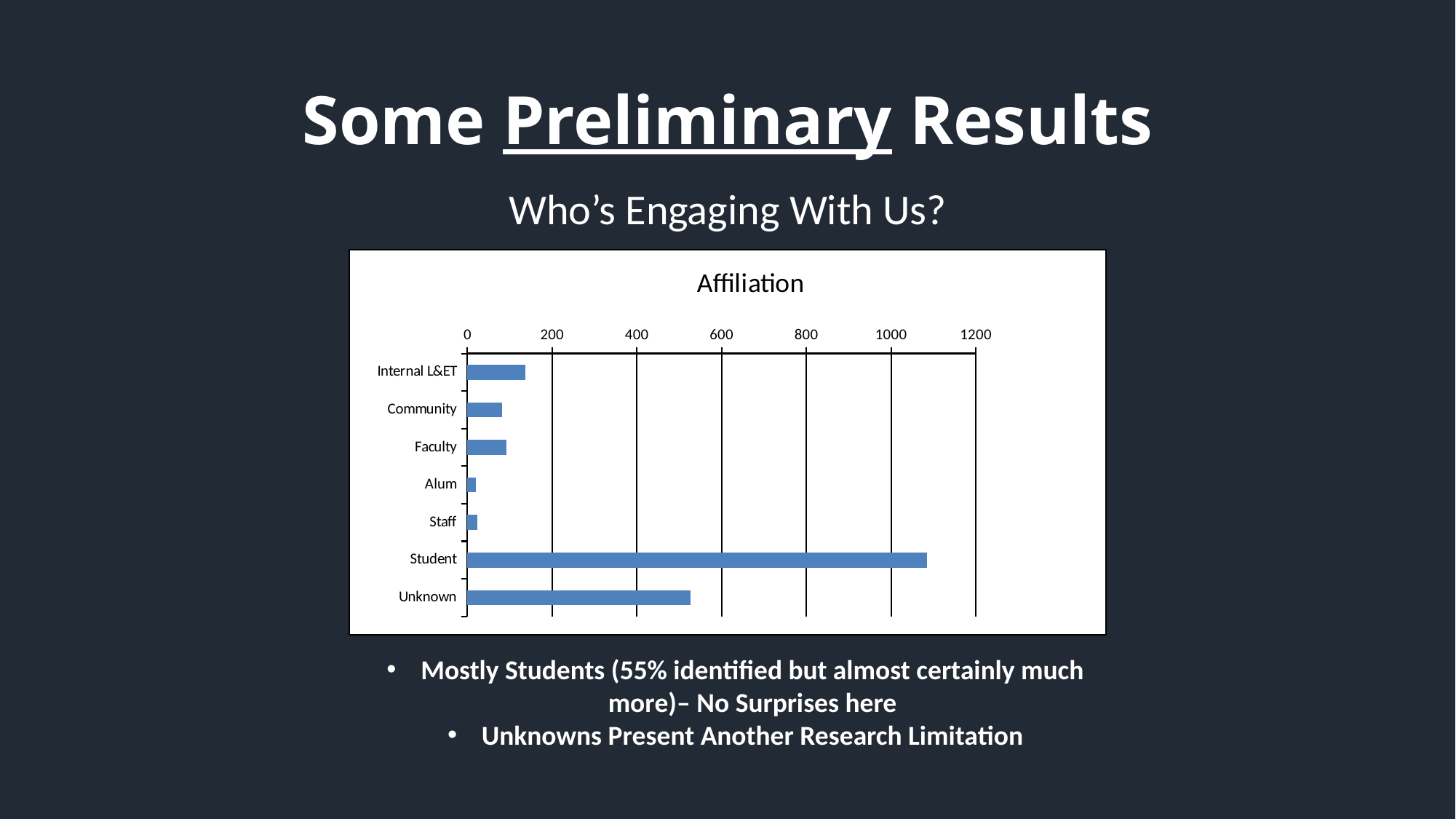
Which is larger, the value for Internal L&ET or the value for Community? Internal L&ET Is the value for Student greater or less than 1200? less What kind of chart is shown on the slide? bar chart Which affiliation category has the highest value? Student Is the value for Internal L&ET greater or less than 200? less What is the title of the chart? Affiliation Which is larger, the value for Unknown or the value for Faculty? Unknown Is the value for Unknown greater or less than 400? greater How many affiliation categories are plotted in the chart? 7 Which is larger, the value for Student or the value for Unknown? Student